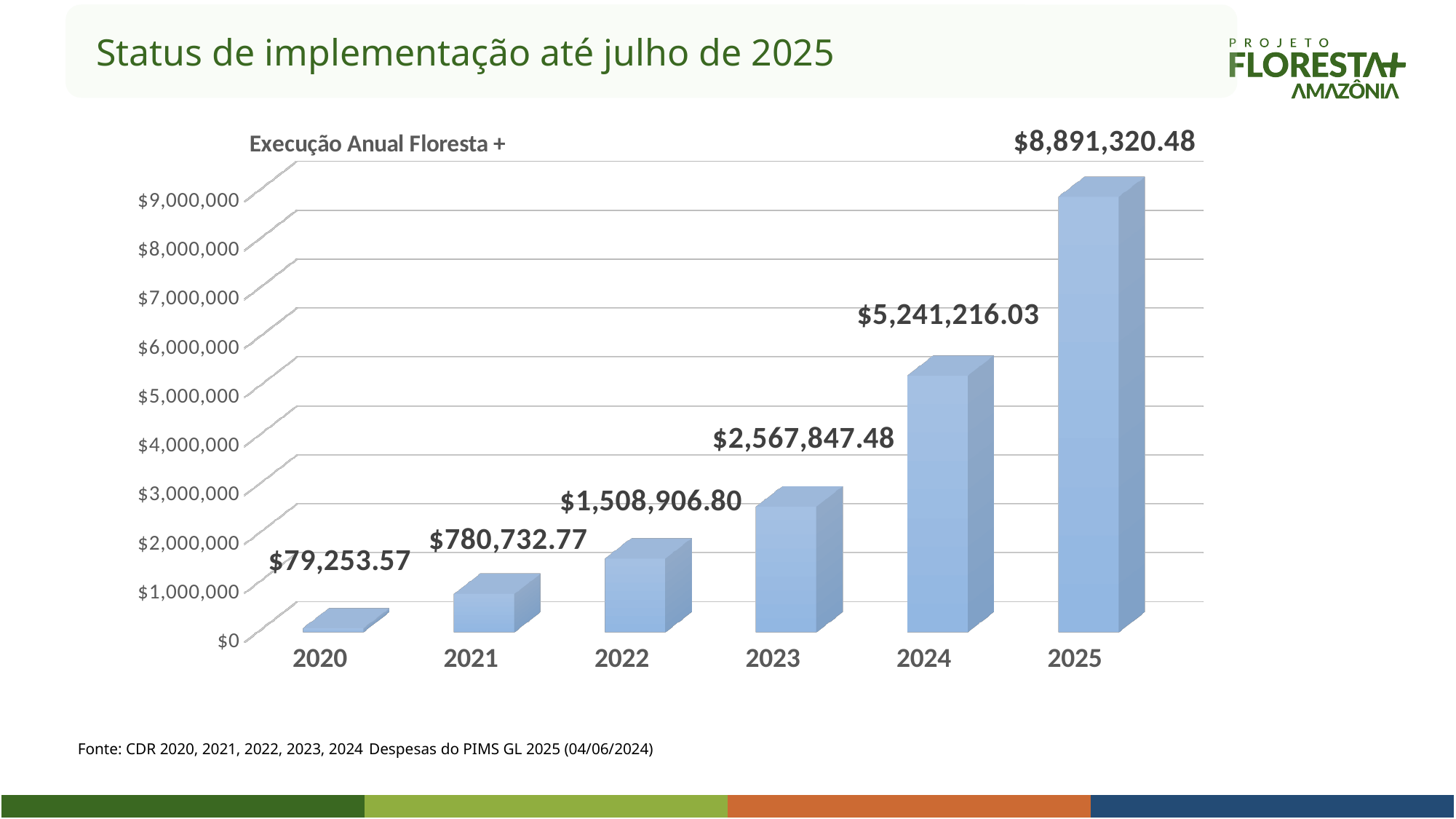
Is the value for 2024 in the Execução Anual Floresta + chart greater or less than $5,000,000? greater Do the values in the Execução Anual Floresta + chart rise or fall from 2020 to 2025? rise What is the value for 2022 in the Execução Anual Floresta + chart? $1,508,906.80 What is the difference between the values for 2025 and 2024 in the Execução Anual Floresta + chart? $3,650,104.45 What kind of chart is the Execução Anual Floresta + chart? bar chart Which is larger in the Execução Anual Floresta + chart, the value for 2023 or the value for 2022? 2023 How many years are shown on the x axis of the Execução Anual Floresta + chart? 6 What is the value for 2025 in the Execução Anual Floresta + chart? $8,891,320.48 Which year has the highest value in the Execução Anual Floresta + chart? 2025 Which year has the lowest value in the Execução Anual Floresta + chart? 2020 What is the value for 2020 in the Execução Anual Floresta + chart? $79,253.57 What is the difference between the values for 2021 and 2020 in the Execução Anual Floresta + chart? $701,479.20